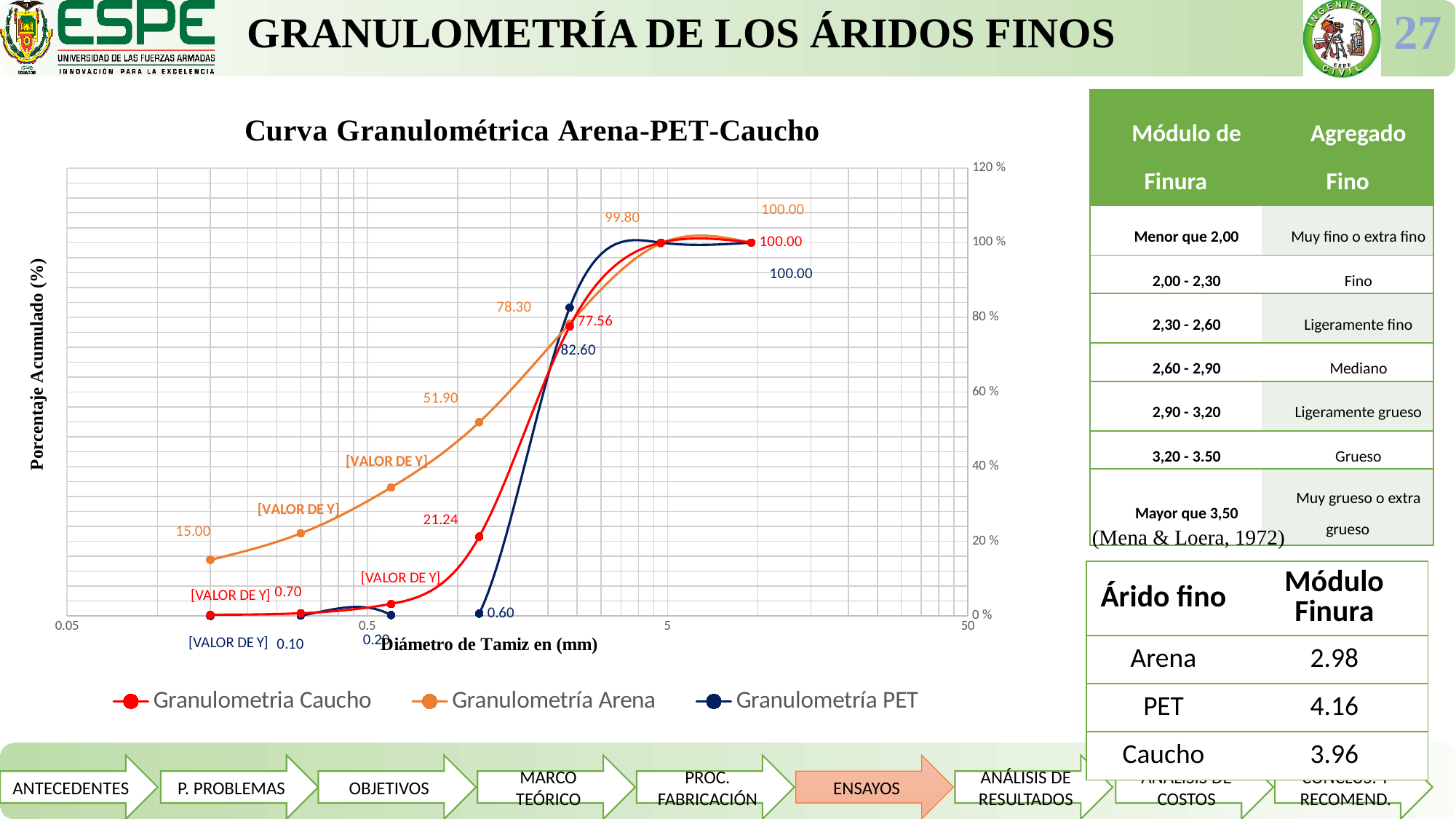
What is the lowest labelled value on the Granulometría Arena series? 15.00 At the sieve size where Granulometría PET is labelled 82.60 and Granulometría Arena is labelled 78.30, which series has the larger value? Granulometría PET What is the data label on the Granulometria Caucho series at the point just below 80%? 77.56 What is the title of the vertical axis of the chart? Porcentaje Acumulado (%) Do the values of the Granulometría PET series rise or fall as the sieve diameter increases along the x axis? rise Which series has the data label 51.90? Granulometría Arena At the sieve size where Granulometría PET is labelled 82.60 and Granulometria Caucho is labelled 77.56, what is the difference between the two values? 5.04 Is the value of the Granulometría Arena series at the point labelled [VALOR DE Y] near 0.5 mm greater or less than 20%? greater What kind of chart is shown on the slide? line chart How many series does the legend of the chart list? 3 What is the title of the chart? Curva Granulométrica Arena-PET-Caucho Which series has the data label 82.60? Granulometría PET